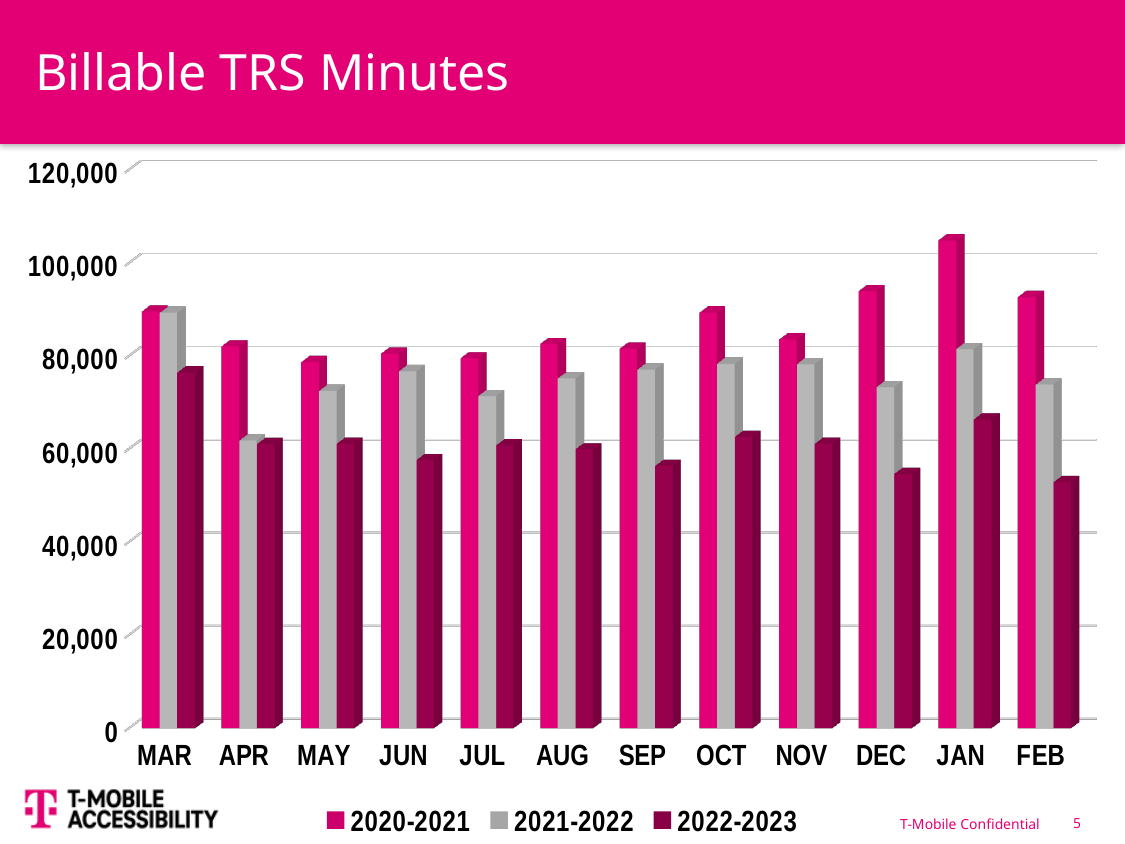
Is the value for JAN in the 2020-2021 series greater or less than 100,000? greater How many series does the legend list? 3 Which month has the lowest value for the 2021-2022 series? APR Which month has the highest value for the 2022-2023 series? MAR Is the value for DEC in the 2022-2023 series greater or less than 60,000? less How many months are shown along the x axis? 12 Is the value for APR in the 2021-2022 series greater or less than 80,000? less Which series is shown in gray in the legend? 2021-2022 What is the title of the chart? Billable TRS Minutes What kind of chart is shown on the slide? bar chart For OCT, which series has the larger value: 2020-2021 or 2022-2023? 2020-2021 Which month has the highest value for the 2020-2021 series? JAN